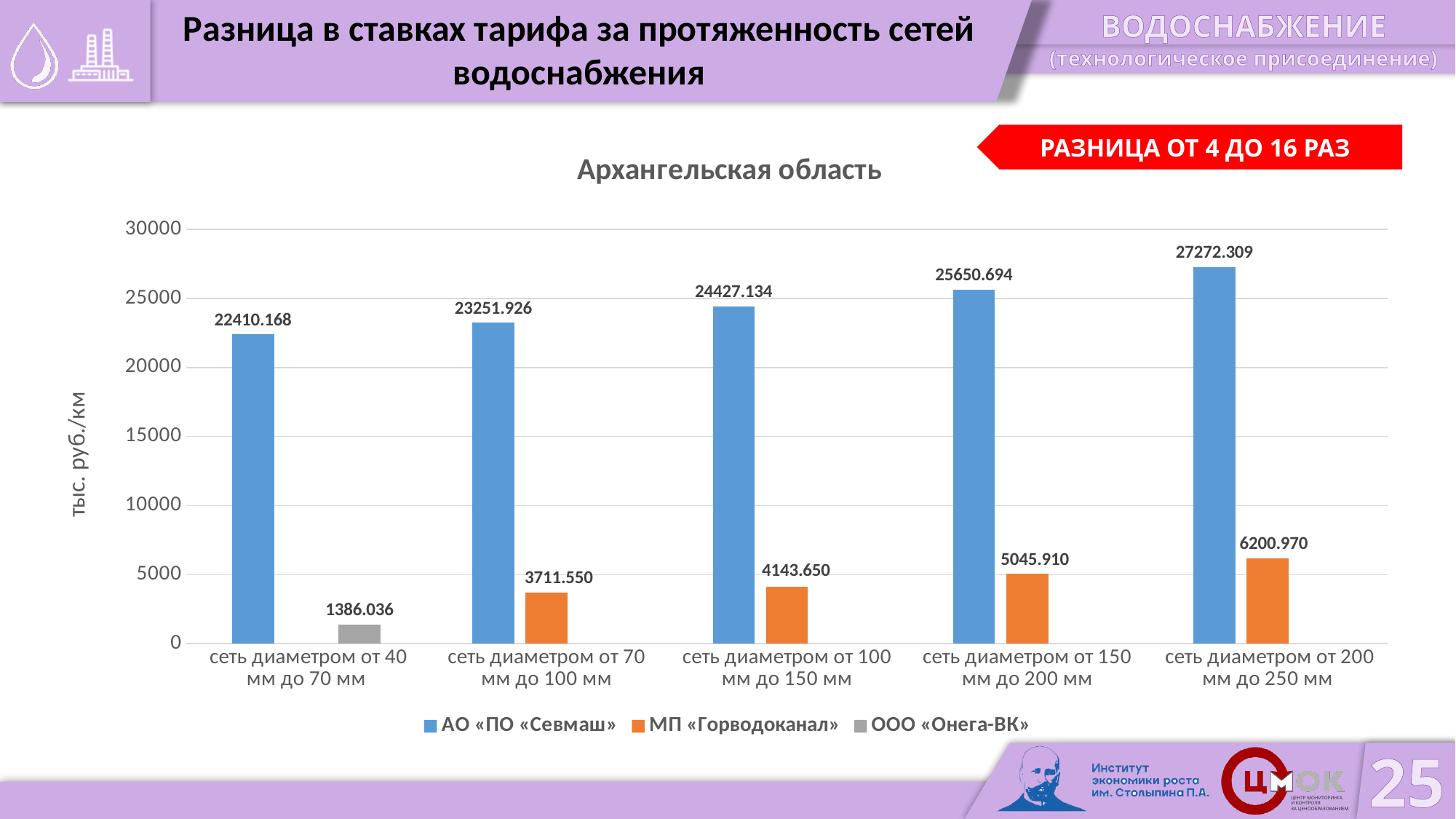
What is the value for МП «Горводоканал» for the category «сеть диаметром от 70 мм до 100 мм»? 3711.550 What is the difference between the values for АО «ПО «Севмаш» and МП «Горводоканал» for the category «сеть диаметром от 200 мм до 250 мм»? 21071.339 What is the value for АО «ПО «Севмаш» for the category «сеть диаметром от 200 мм до 250 мм»? 27272.309 What is the value for МП «Горводоканал» for the category «сеть диаметром от 150 мм до 200 мм»? 5045.910 Which is larger: the value for АО «ПО «Севмаш» for «сеть диаметром от 100 мм до 150 мм» or for «сеть диаметром от 150 мм до 200 мм»? сеть диаметром от 150 мм до 200 мм For which category is the value for МП «Горводоканал» the lowest? сеть диаметром от 70 мм до 100 мм How many series does the legend list? 3 How many categories are shown on the x axis? 5 Do the values for АО «ПО «Севмаш» rise or fall from left to right along the x axis? rise What is the difference between the МП «Горводоканал» values for «сеть диаметром от 200 мм до 250 мм» and «сеть диаметром от 70 мм до 100 мм»? 2489.420 For which category is the value for АО «ПО «Севмаш» the highest? сеть диаметром от 200 мм до 250 мм What is the value for ООО «Онега-ВК» for the category «сеть диаметром от 40 мм до 70 мм»? 1386.036